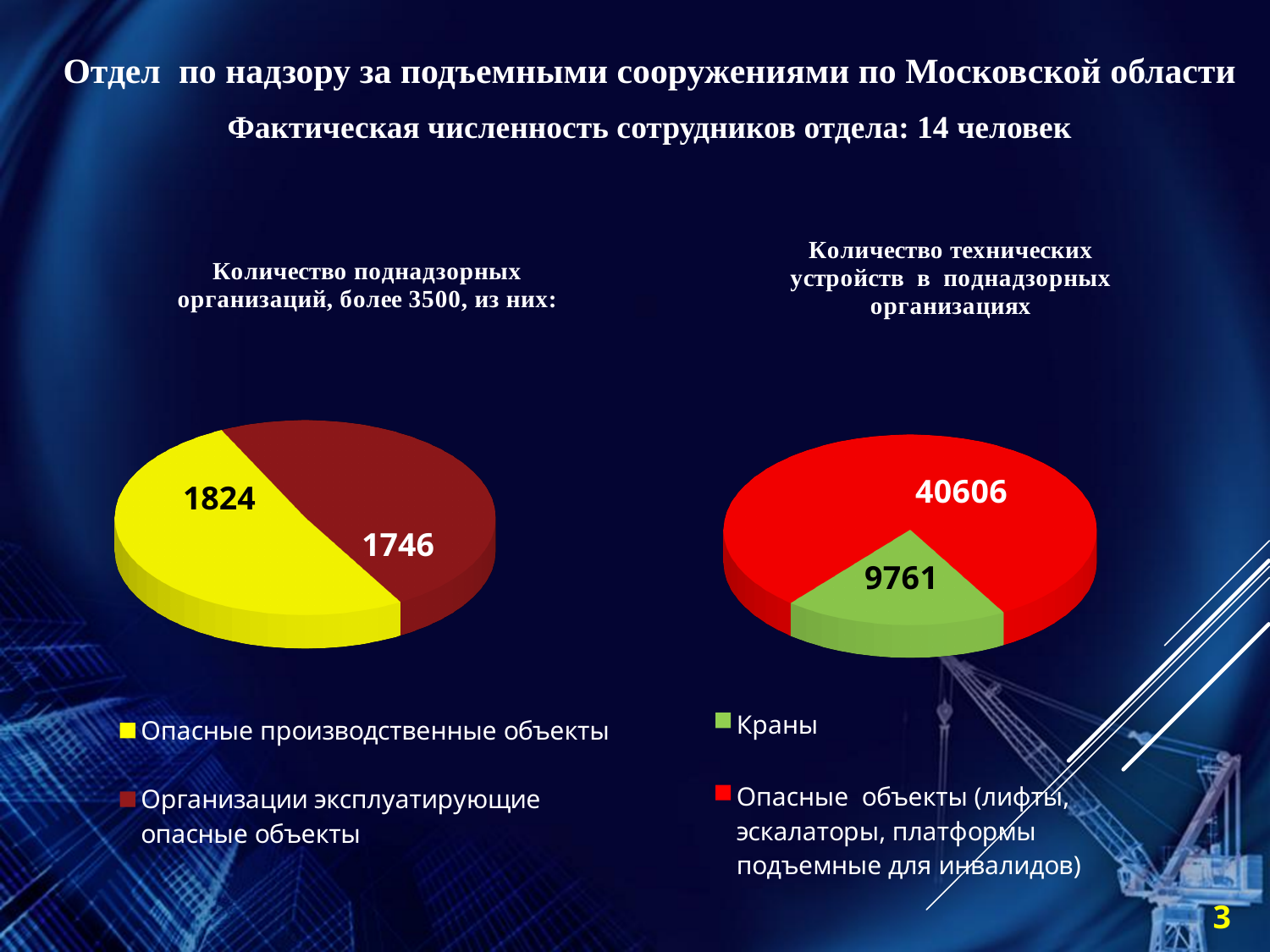
In the right pie chart (Количество технических устройств в поднадзорных организациях), what is the value for Опасные объекты (лифты, эскалаторы, платформы подъемные для инвалидов)? 40606 In the left pie chart (Количество поднадзорных организаций), what is the value for Организации эксплуатирующие опасные объекты? 1746 How many entries does the legend of the left pie chart (Количество поднадзорных организаций) list? 2 In the left pie chart (Количество поднадзорных организаций), what is the value for Опасные производственные объекты? 1824 What type of chart is used on the left side of the slide (Количество поднадзорных организаций)? Pie chart In the right pie chart (Количество технических устройств в поднадзорных организациях), what colour is the slice for Краны? Green In the right pie chart (Количество технических устройств в поднадзорных организациях), how much larger is the value for Опасные объекты than the value for Краны? 30845 How many slices does the right pie chart (Количество технических устройств в поднадзорных организациях) have? 2 In the left pie chart (Количество поднадзорных организаций), what is the difference between the two slice values? 78 In the left pie chart (Количество поднадзорных организаций), which category has the larger value? Опасные производственные объекты In the right pie chart (Количество технических устройств в поднадзорных организациях), which category has the smallest value? Краны In the right pie chart (Количество технических устройств в поднадзорных организациях), what is the value for Краны? 9761